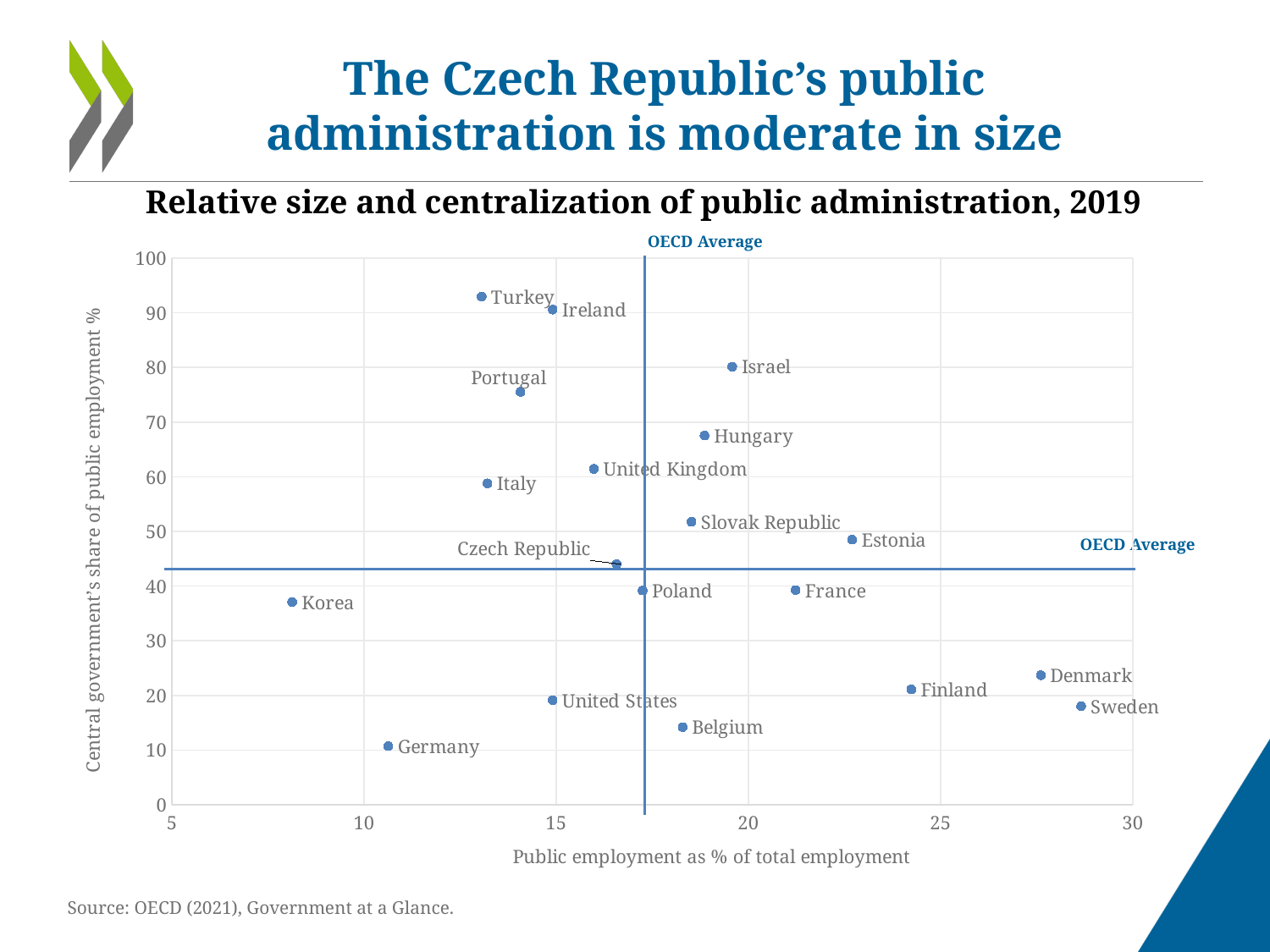
What kind of chart is shown on the slide? Scatter chart Is the central government's share of public employment for Israel greater or less than 70? greater How many countries are plotted on the chart? 19 Which country has the highest central government's share of public employment? Turkey Is the central government's share of public employment for Belgium greater or less than 20? less Which has a higher central government's share of public employment, Israel or Hungary? Israel Which country has the lowest central government's share of public employment? Germany Which country has the lowest public employment as % of total employment? Korea Which country has the highest public employment as % of total employment? Sweden What is the label of the x axis? Public employment as % of total employment Which has a higher public employment as % of total employment, Finland or Sweden? Sweden Is the public employment as % of total employment for Korea greater or less than 10? less